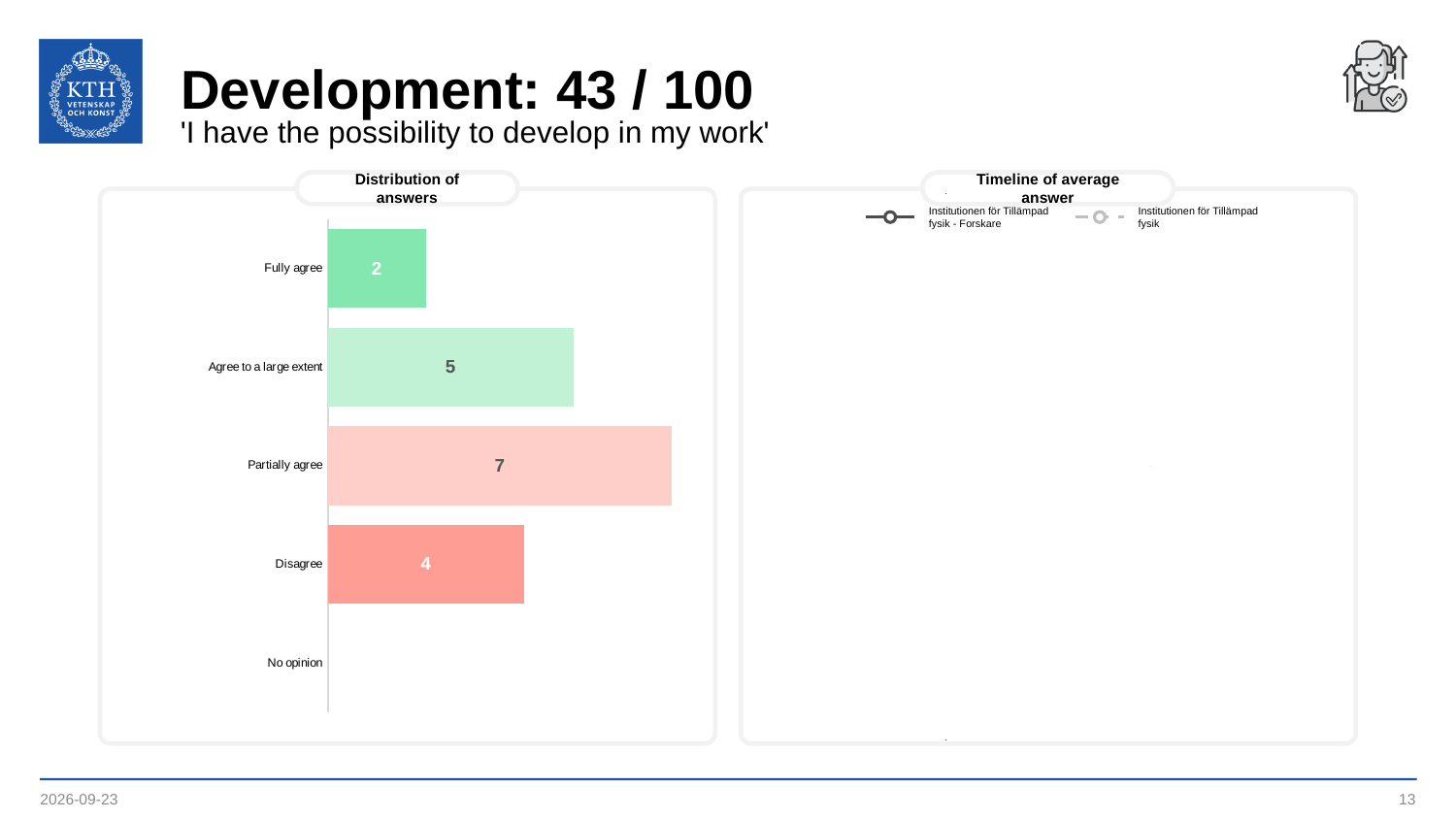
How many series does the legend of the 'Timeline of average answer' chart list? 2 How many answer categories are listed on the y axis of the 'Distribution of answers' chart? 5 What kind of chart is the 'Distribution of answers' chart? Bar chart In the 'Distribution of answers' chart, what is the value for 'Disagree'? 4 In the 'Distribution of answers' chart, how many respondents chose 'Partially agree'? 7 In the 'Distribution of answers' chart, which of the labelled bars has the lowest value? Fully agree In the 'Distribution of answers' chart, which answer category has the highest value? Partially agree In the 'Distribution of answers' chart, what is the value for 'Agree to a large extent'? 5 In the 'Distribution of answers' chart, what is the value for 'Fully agree'? 2 In the 'Distribution of answers' chart, what is the difference between 'Partially agree' and 'Fully agree'? 5 In the 'Distribution of answers' chart, which is larger: 'Agree to a large extent' or 'Disagree'? Agree to a large extent In the 'Distribution of answers' chart, what is the total of the four labelled bars? 18